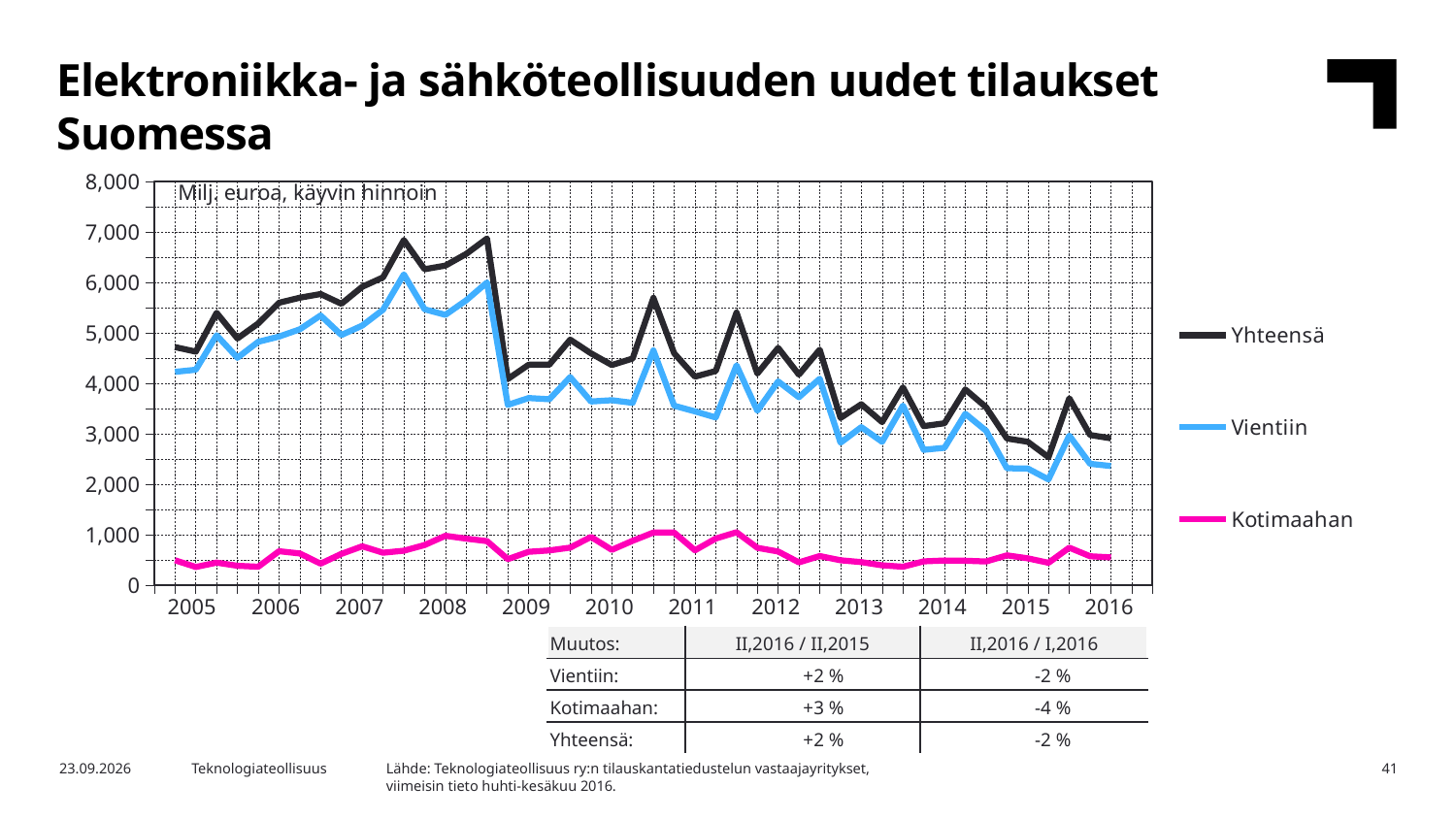
What are the three series named in the legend? Yhteensä, Vientiin, Kotimaahan Does the Yhteensä series overall rise or fall from 2008 to 2016? fall What kind of chart is shown on the slide? line chart Is the value for Kotimaahan in 2010 greater or less than 2,000? less Which series is larger in 2012, Vientiin or Kotimaahan? Vientiin What unit label is shown inside the chart area? Milj. euroa, käyvin hinnoin How many series does the legend list? 3 Is the value for Yhteensä in 2008 greater or less than 5,000? greater Is the value for Vientiin in 2016 greater or less than 3,000? less Which series has the lowest values throughout the chart? Kotimaahan Which series has the highest values throughout the chart? Yhteensä How many years are labeled on the x axis? 12